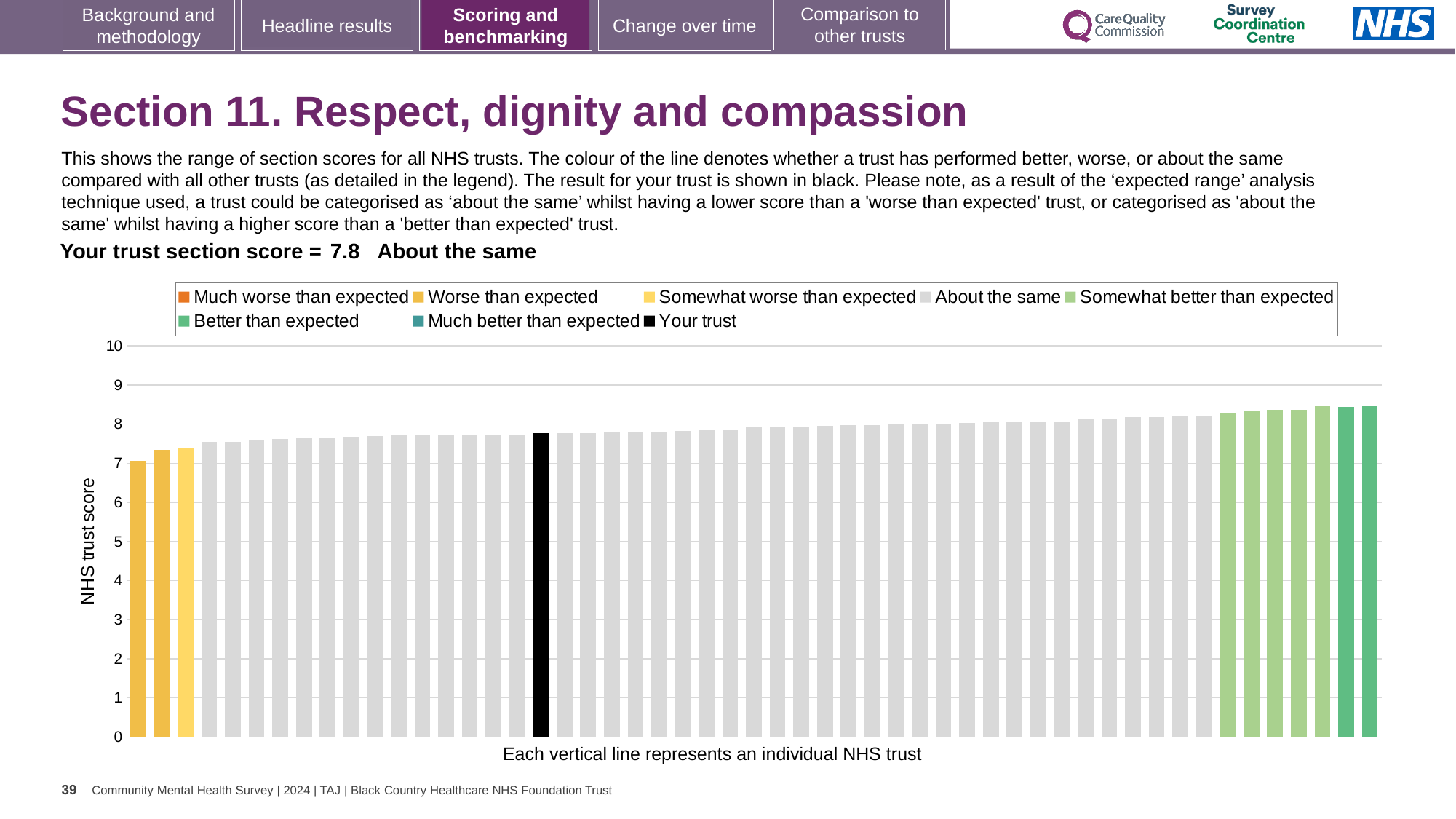
Is the value of the lowest bar greater or less than 8? less Do the trust scores rise or fall from left to right along the x axis? rise Is the value of the highest bar greater or less than 8? greater What is the section score for your trust shown on the slide? 7.8 What is the label on the vertical axis of the chart? NHS trust score What colour is the bar representing your trust? black How many entries does the chart legend list? 8 Which performance category is your trust placed in for Section 11? About the same Which is larger: the score for your trust (black bar) or the score of the leftmost bar? your trust How many bars are coloured as 'Worse than expected'? 2 What kind of chart is shown on the slide? bar chart Is the value of the highest bar greater or less than 9? less